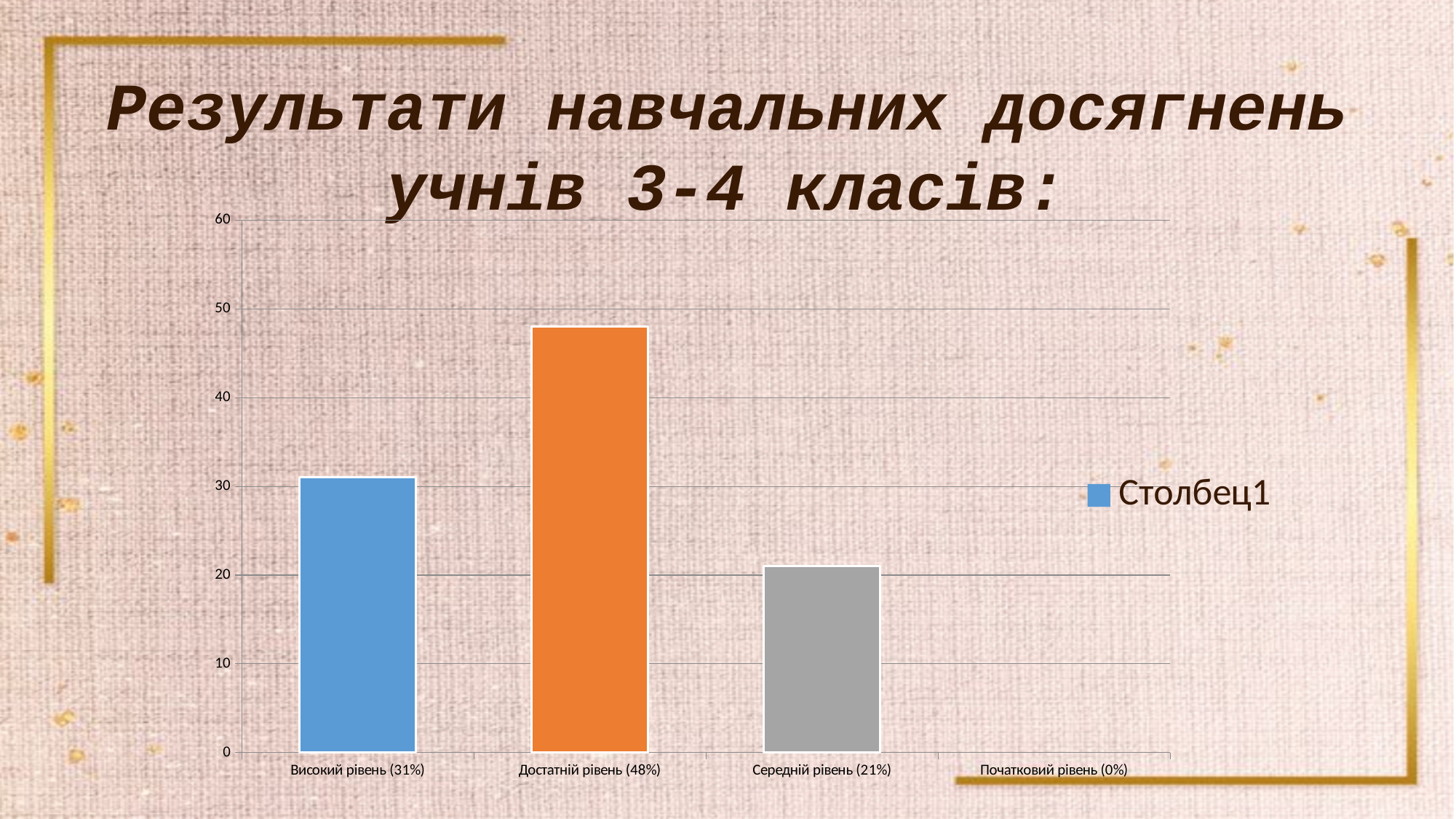
What percentage is shown for Середній рівень in the chart? 21% What is the name of the series in the chart legend? Столбец1 How many categories are shown on the x axis of the chart? 4 What is the difference between the values for Достатній рівень and Середній рівень? 27% How many series does the chart legend list? 1 Which is larger, the value for Високий рівень or the value for Середній рівень? Високий рівень Which category has the highest bar in the chart? Достатній рівень (48%) Which category has the lowest bar in the chart? Початковий рівень (0%) Is the value for Достатній рівень greater or less than 40? greater What kind of chart is shown on the slide? bar chart What is the title of the slide above the chart? Результати навчальних досягнень учнів 3-4 класів: What percentage is shown for Високий рівень in the chart? 31%